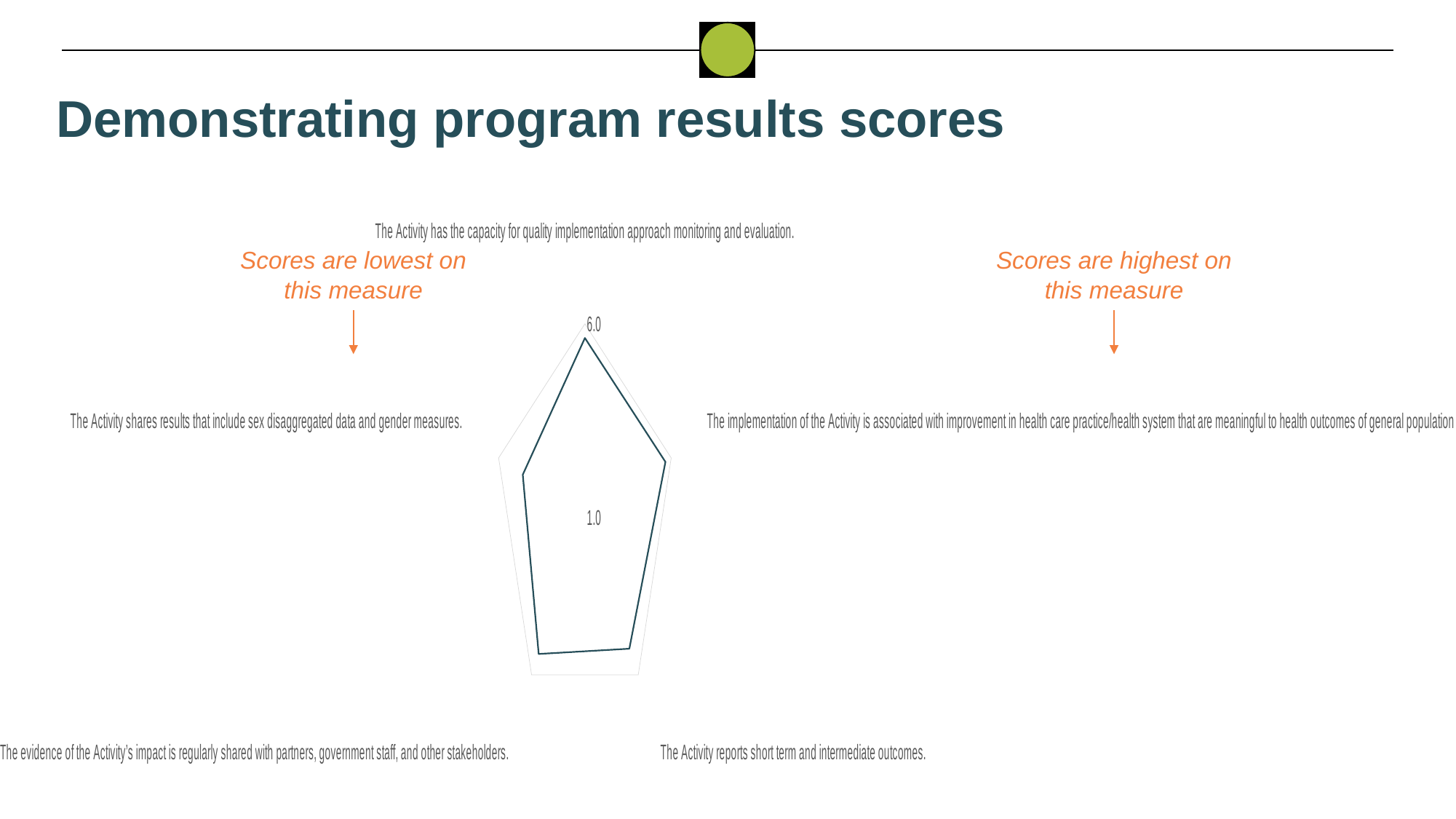
According to the slide's annotation, on which measure are scores highest? The implementation of the Activity is associated with improvement in health care practice/health system that are meaningful to health outcomes of general population What kind of chart is shown on the slide? Radar chart What is the title of the slide containing the radar chart? Demonstrating program results scores Is the value for 'The Activity reports short term and intermediate outcomes' greater or less than 1.0? greater Is the value for 'The evidence of the Activity's impact is regularly shared with partners, government staff, and other stakeholders' greater or less than 6.0? less According to the slide's annotation, on which measure are scores lowest? The Activity shares results that include sex disaggregated data and gender measures. What is the highest value labelled on the radar chart's scale? 6.0 Is the value for 'The Activity shares results that include sex disaggregated data and gender measures' greater or less than 6.0? less How many measures (axes) does the radar chart have? 5